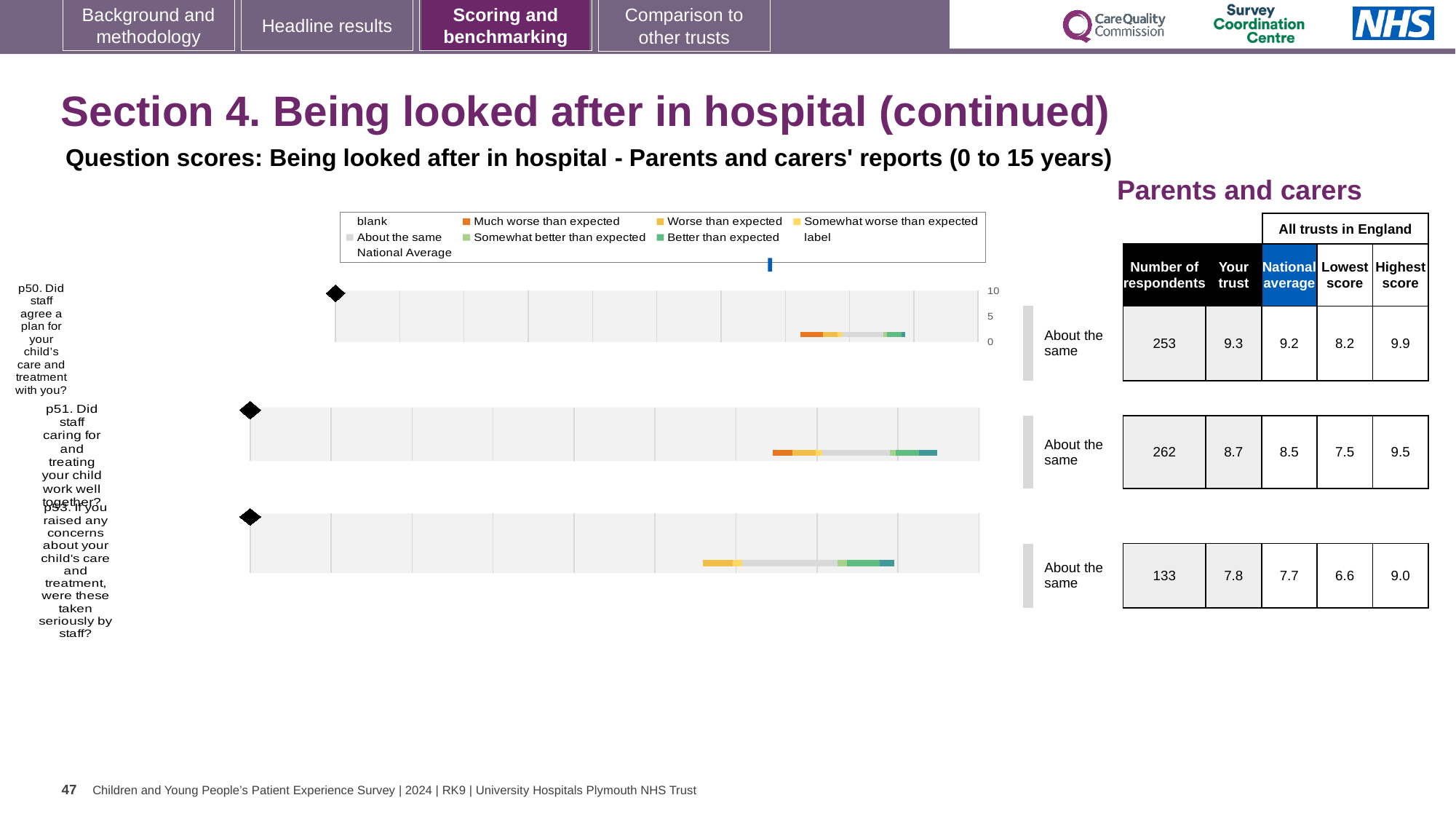
Which has the larger 'Your trust' score, question p50 or question p53? p50 What is the 'Your trust' score for question p51 (Did staff caring for and treating your child work well together?)? 8.7 For question p53, what is the difference between the highest score and the lowest score among all trusts in England? 2.4 How many respondents are shown for question p50 (Did staff agree a plan for your child's care and treatment with you?)? 253 What is the highest score among all trusts in England for question p50? 9.9 What is the lowest score among all trusts in England for question p51? 7.5 What benchmark category is shown for question p50? About the same Which of the three questions shown has the lowest number of respondents? p53 What is the national average score for question p53 (If you raised any concerns about your child's care and treatment, were these taken seriously by staff?)? 7.7 Which of the three questions shown has the highest 'Your trust' score? p50 How many questions are plotted on this slide? 3 For question p51, what is the difference between the 'Your trust' score and the national average? 0.2